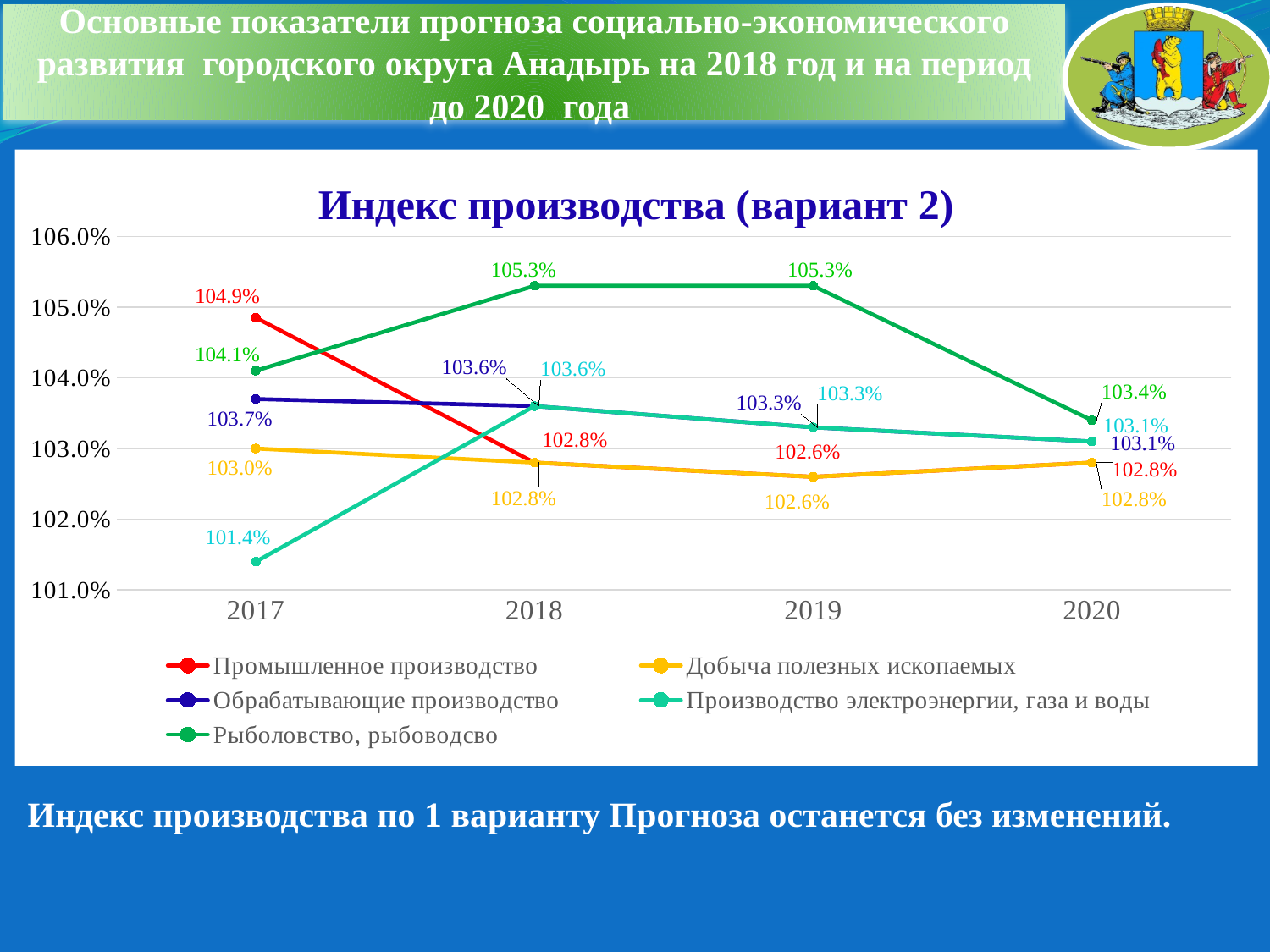
What is the value for Промышленное производство in 2017? 104.9% How many years are shown on the x axis? 4 Which is larger in 2020: Рыболовство, рыбоводсво or Обрабатывающие производство? Рыболовство, рыбоводсво What is the value for Рыболовство, рыбоводсво in 2018? 105.3% What is the value for Производство электроэнергии, газа и воды in 2017? 101.4% Does the value for Рыболовство, рыбоводсво rise or fall from 2019 to 2020? fall What type of chart is shown on the slide? line chart What is the title of the chart? Индекс производства (вариант 2) How many series does the legend list? 5 What is the difference between the 2017 and 2018 values for Промышленное производство? 2.1% Which series has the highest value in 2019? Рыболовство, рыбоводсво Which series has the lowest value in 2017? Производство электроэнергии, газа и воды